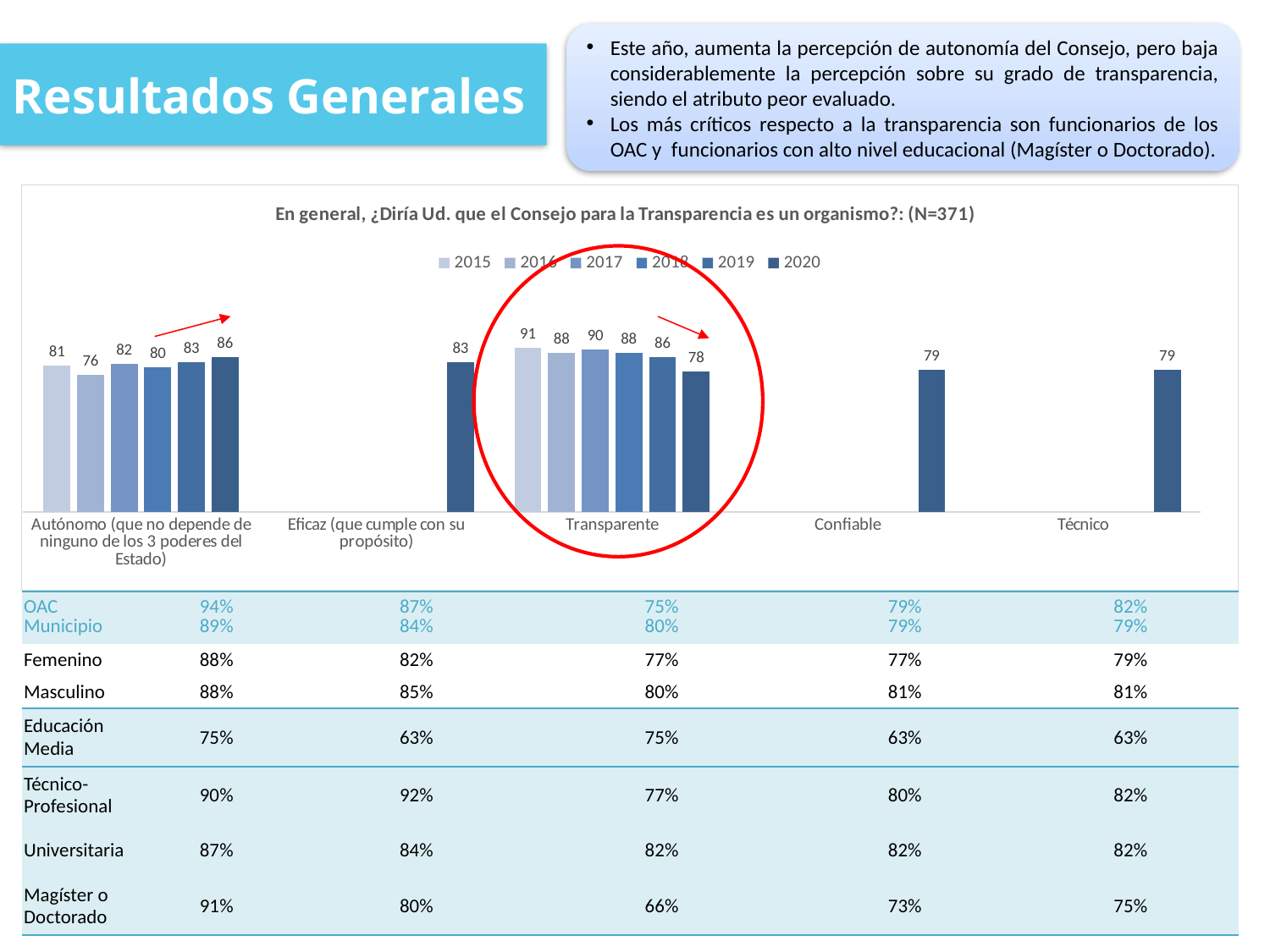
What is the 2015 value for Transparente? 91 How many series does the legend list? 6 What is the difference between the 2015 and 2020 values for Transparente? 13 Which year has the highest value for Transparente? 2015 What is the 2020 value for Transparente? 78 What is the value shown for Eficaz (que cumple con su propósito)? 83 Which is larger in 2020: the value for Autónomo or the value for Transparente? Autónomo Which year has the lowest value for Autónomo? 2016 Do the values for Transparente rise or fall from 2017 to 2020? Fall How many categories are shown along the x axis? 5 What is the 2020 value for Autónomo (que no depende de ninguno de los 3 poderes del Estado)? 86 What kind of chart is shown? Bar chart